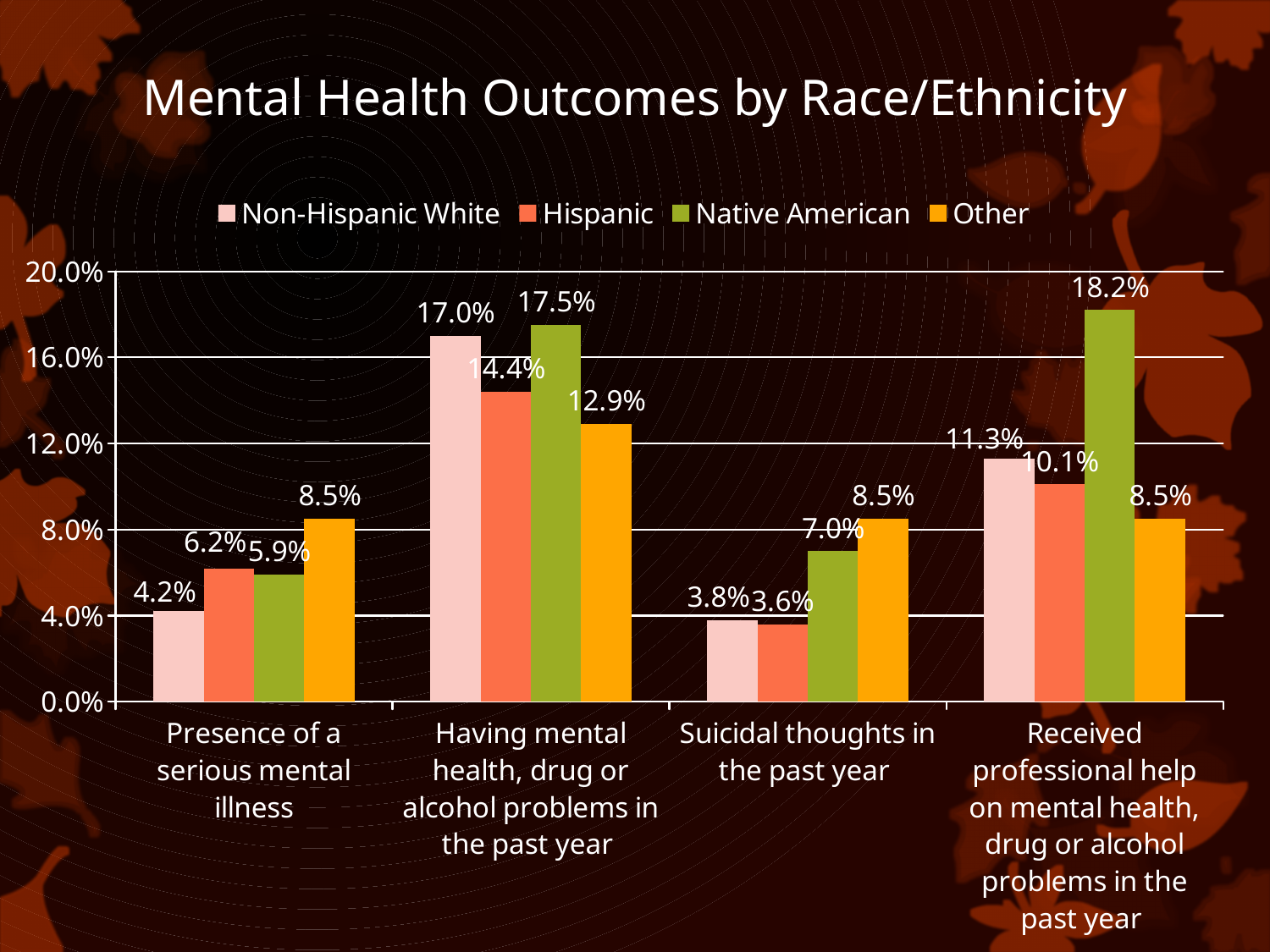
What is the value for Native American in the 'Received professional help on mental health, drug or alcohol problems in the past year' category? 18.2% What is the difference between the Native American and Other values in the 'Received professional help on mental health, drug or alcohol problems in the past year' category? 9.7% Which group has the highest value for 'Suicidal thoughts in the past year'? Other How many categories are shown on the x axis? 4 What kind of chart is shown on the slide? Bar chart What is the value for Non-Hispanic White in the 'Presence of a serious mental illness' category? 4.2% Is the Native American value for 'Having mental health, drug or alcohol problems in the past year' greater or less than 16.0%? greater How many series does the legend list? 4 What is the value for Hispanic in the 'Having mental health, drug or alcohol problems in the past year' category? 14.4% Which group has the lowest value for 'Having mental health, drug or alcohol problems in the past year'? Other What is the title of the chart? Mental Health Outcomes by Race/Ethnicity Which is larger in the 'Presence of a serious mental illness' category: the Hispanic value or the Other value? Other